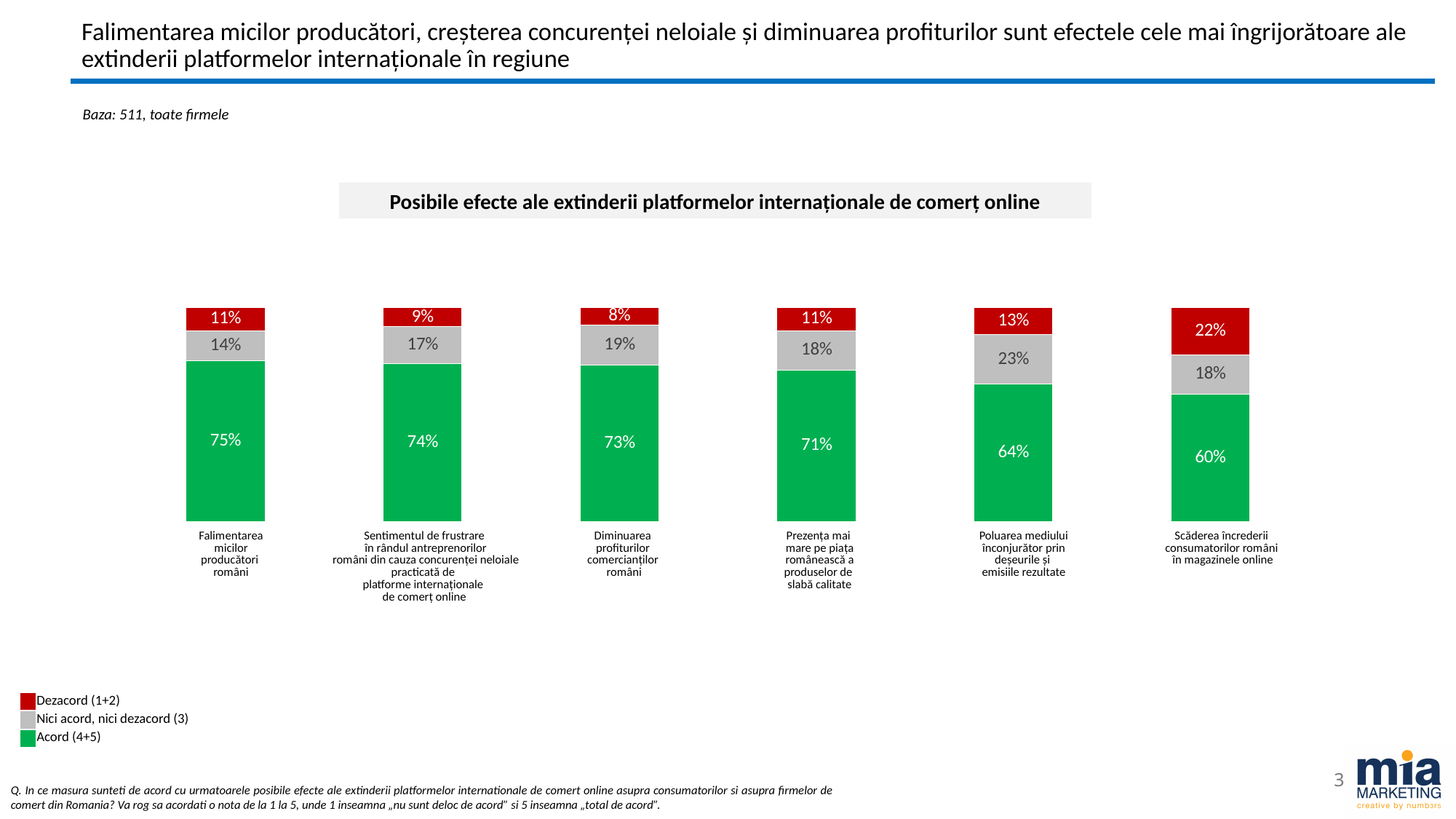
What is the difference between the 'Acord (4+5)' values for 'Falimentarea micilor producători români' and 'Scăderea încrederii consumatorilor români în magazinele online'? 15% What is the 'Acord (4+5)' value for 'Falimentarea micilor producători români'? 75% Which category has the highest 'Acord (4+5)' value? Falimentarea micilor producători români What kind of chart is shown on the slide? Stacked bar chart Which has a larger 'Nici acord, nici dezacord (3)' value: 'Diminuarea profiturilor comercianților români' or 'Falimentarea micilor producători români'? Diminuarea profiturilor comercianților români How many series does the legend list? 3 Do the 'Acord (4+5)' values rise or fall from left to right across the categories? Fall What is the title of the chart? Posibile efecte ale extinderii platformelor internaționale de comerț online Which category has the lowest 'Dezacord (1+2)' value? Diminuarea profiturilor comercianților români How many categories are shown in the chart? 6 What is the 'Nici acord, nici dezacord (3)' value for 'Poluarea mediului înconjurător prin deșeurile și emisiile rezultate'? 23% What is the 'Dezacord (1+2)' value for 'Scăderea încrederii consumatorilor români în magazinele online'? 22%